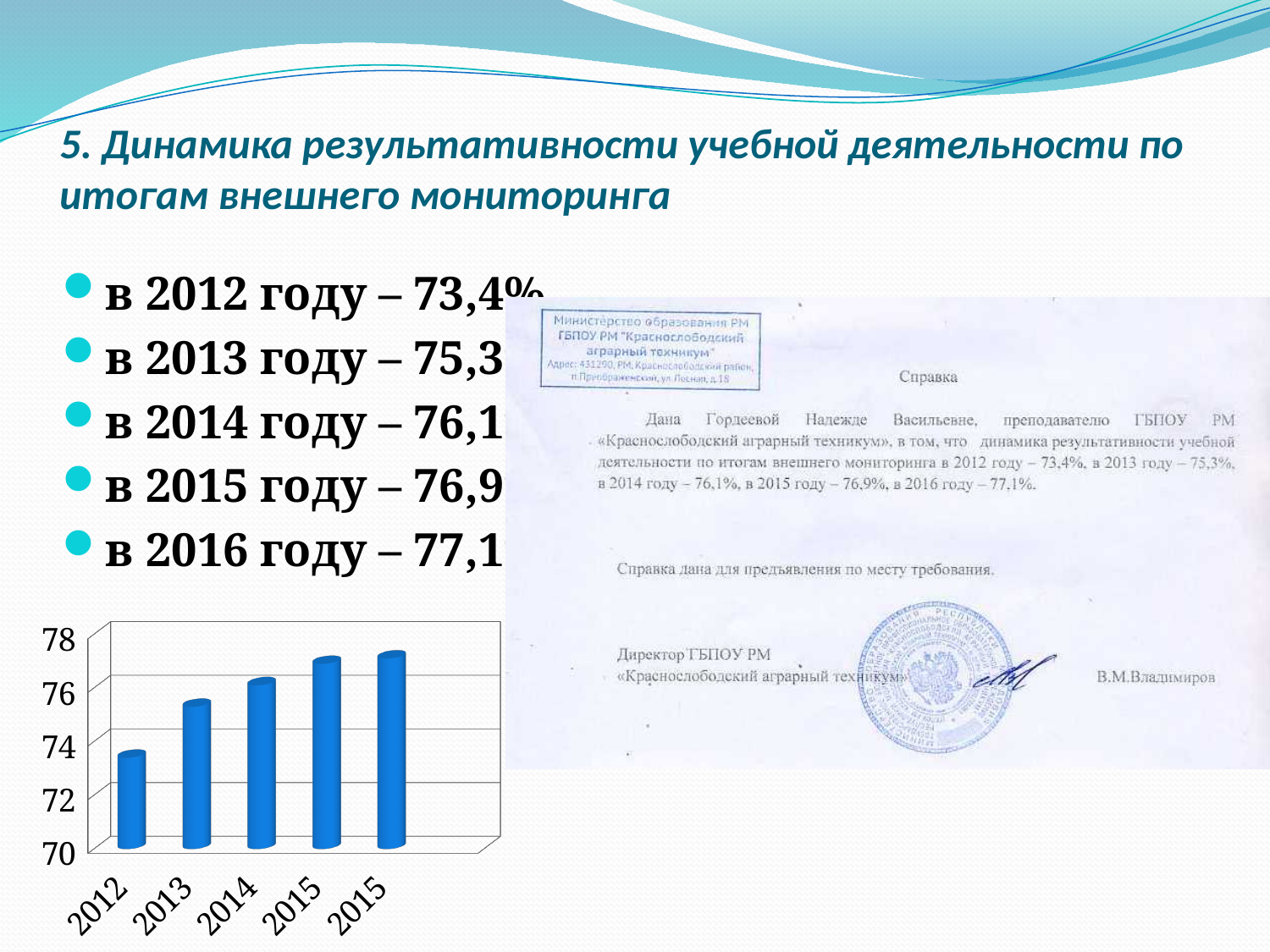
Is the value for 2013 greater or less than 76? less Is the value of the rightmost bar greater or less than 76? greater Which year has the lowest bar in the chart? 2012 What kind of chart is shown on the slide? Bar chart Is the value for 2014 greater or less than 74? greater Which x-axis label appears twice in the chart? 2015 Do the bar values rise or fall from left to right along the x axis? Rise How many bars are plotted in the chart? 5 Which is larger, the bar for 2012 or the bar for 2013? 2013